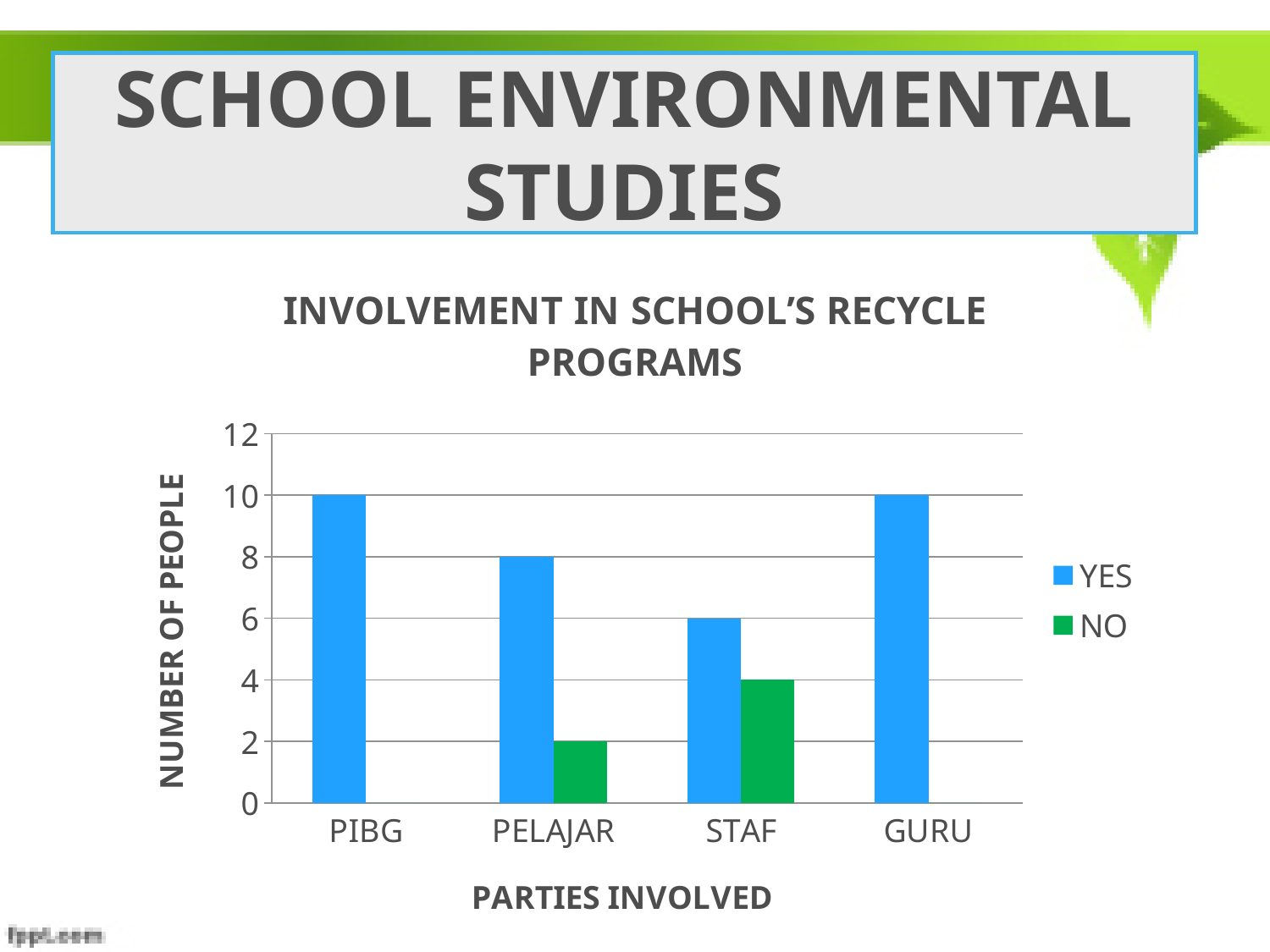
What is the NO value for PELAJAR? 2 How many series does the legend list? 2 What type of chart is shown on the slide? bar chart What is the YES value for PELAJAR? 8 What is the label of the y axis? NUMBER OF PEOPLE Which category has the lowest YES value? STAF What is the YES value for PIBG? 10 What is the title of the chart? INVOLVEMENT IN SCHOOL'S RECYCLE PROGRAMS What is the NO value for STAF? 4 How many categories are shown on the x axis? 4 What is the difference between the YES and NO values for STAF? 2 Which is larger, the YES value for PELAJAR or the YES value for STAF? PELAJAR